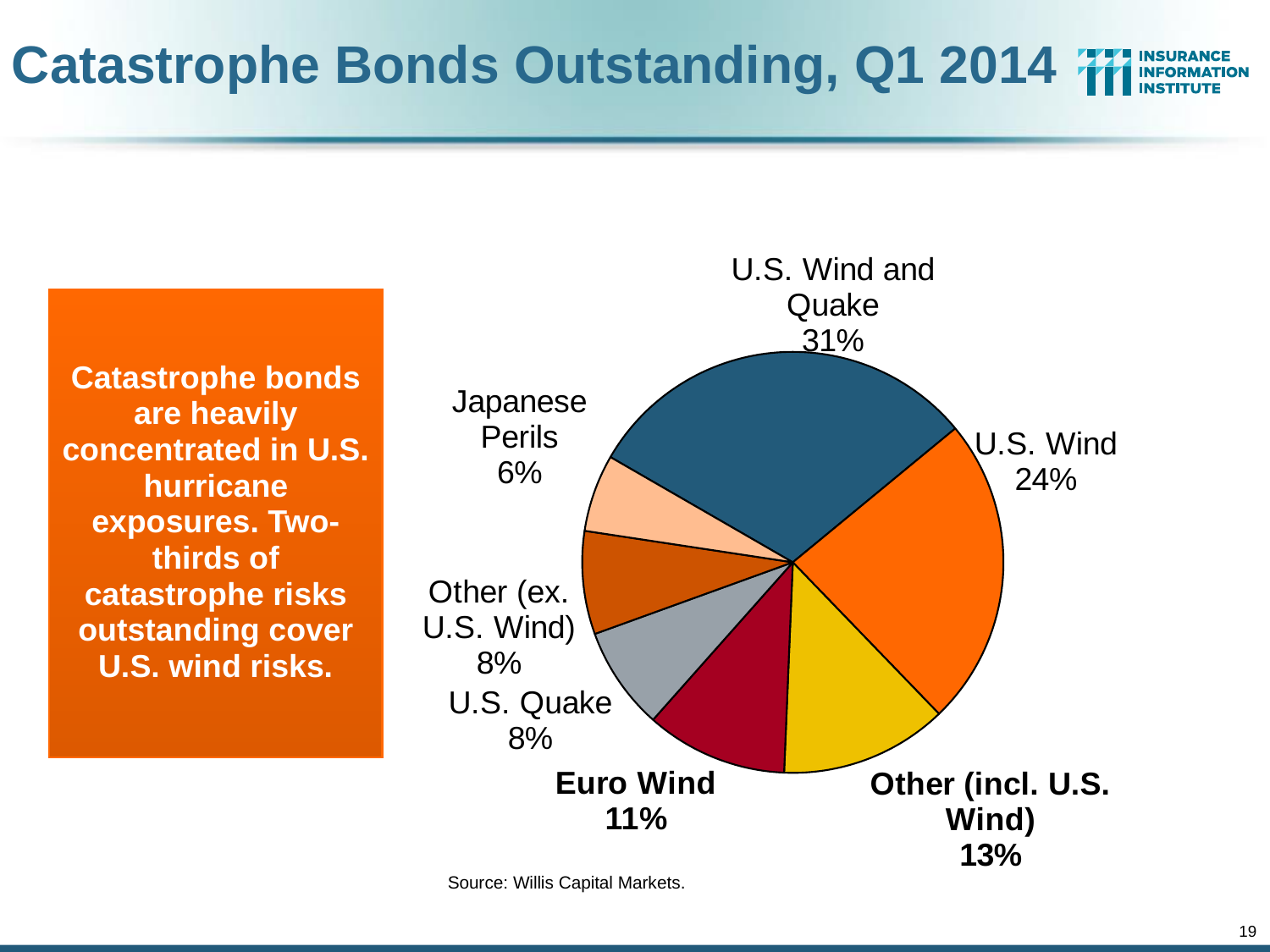
What is the source cited for the chart? Willis Capital Markets What share of the pie is U.S. Wind? 24% What percentage is shown for Japanese Perils? 6% How many slices does the pie chart have? 7 What share is Other (incl. U.S. Wind)? 13% What kind of chart is shown on the slide? Pie chart Which is larger, Euro Wind or Other (incl. U.S. Wind)? Other (incl. U.S. Wind) What is the difference in percentage points between U.S. Wind and Quake and U.S. Wind? 7 percentage points Which category has the largest share of the pie? U.S. Wind and Quake What share of catastrophe bonds outstanding is U.S. Wind and Quake? 31% Which category has the smallest share of the pie? Japanese Perils What percentage is shown for Euro Wind? 11%